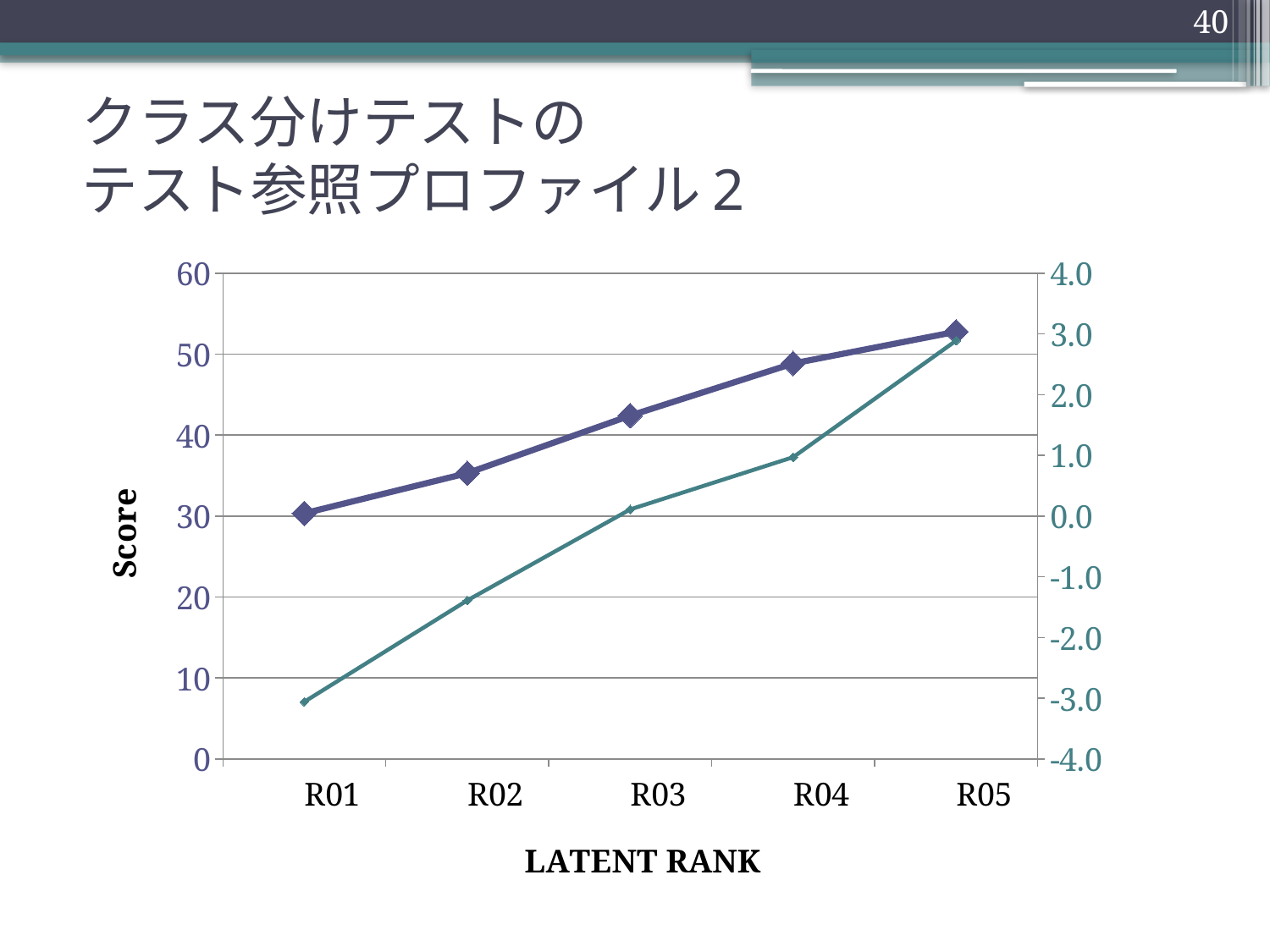
How many data series (lines) are plotted on the chart? 2 Do the values of the thin teal line rise or fall from R01 to R05? rise What kind of chart is shown on the slide? line chart How many latent rank categories are shown on the x axis? 5 On the right axis, is the value of the thin teal line at R01 greater or less than -2.0? less What is the title of the left y axis? Score What is the title of the x axis? LATENT RANK On the left axis, is the value of the thick purple line at R05 greater or less than 50? greater At which latent rank is the thick purple line highest? R05 At which latent rank is the thin teal line lowest? R01 Do the values of the thick purple line rise or fall from R01 to R05? rise On the left axis, is the value of the thick purple line at R01 greater or less than 40? less